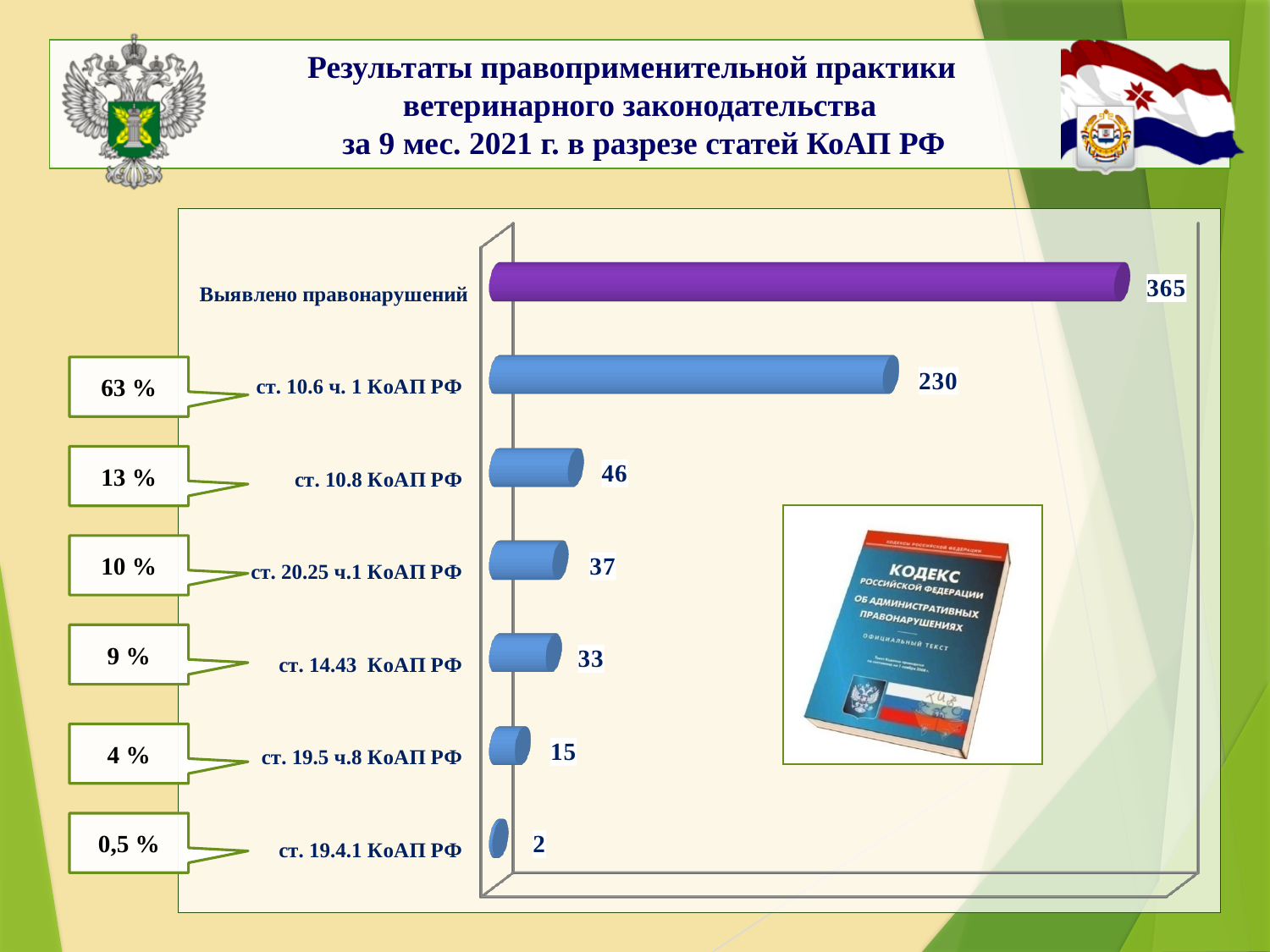
What percentage is shown in the callout next to "ст. 20.25 ч.1 КоАП РФ"? 10 % Which is larger, the value for "ст. 19.5 ч.8 КоАП РФ" or the value for "ст. 14.43 КоАП РФ"? ст. 14.43 КоАП РФ What value is shown for "ст. 10.8 КоАП РФ"? 46 What is the difference between the values for "ст. 20.25 ч.1 КоАП РФ" and "ст. 14.43 КоАП РФ"? 4 What value is shown for "Выявлено правонарушений"? 365 What value is shown for "ст. 14.43 КоАП РФ"? 33 Which category has the highest value? Выявлено правонарушений What value is shown for "ст. 10.6 ч. 1 КоАП РФ"? 230 Which category has the lowest value? ст. 19.4.1 КоАП РФ How many categories are plotted in the chart? 7 What is the difference between the values for "ст. 10.6 ч. 1 КоАП РФ" and "ст. 10.8 КоАП РФ"? 184 What kind of chart is shown on the slide? bar chart